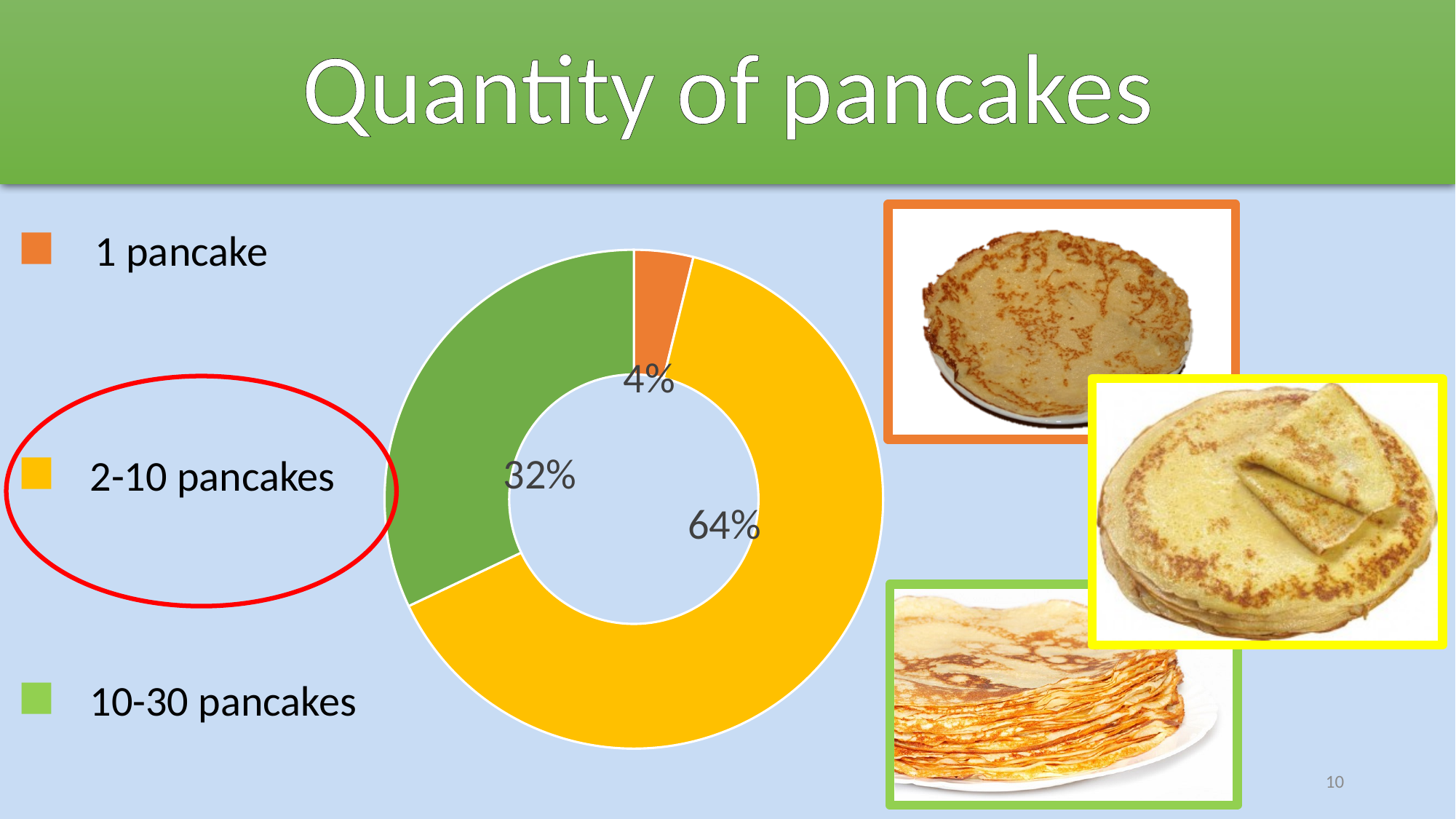
Which category has the smallest share? 1 pancake What kind of chart is shown on the slide? Doughnut (pie) chart What is the difference in percentage points between 2-10 pancakes and 10-30 pancakes? 32 What colour represents the 1 pancake category? Orange Which category has the largest share? 2-10 pancakes What share of the chart is for 10-30 pancakes? 32% What share of the chart is for 1 pancake? 4% What is the title of the slide containing the chart? Quantity of pancakes How many categories does the chart show? 3 What is the difference in percentage points between 10-30 pancakes and 1 pancake? 28 What share of the chart is for 2-10 pancakes? 64% Which is larger, the share for 10-30 pancakes or the share for 1 pancake? 10-30 pancakes